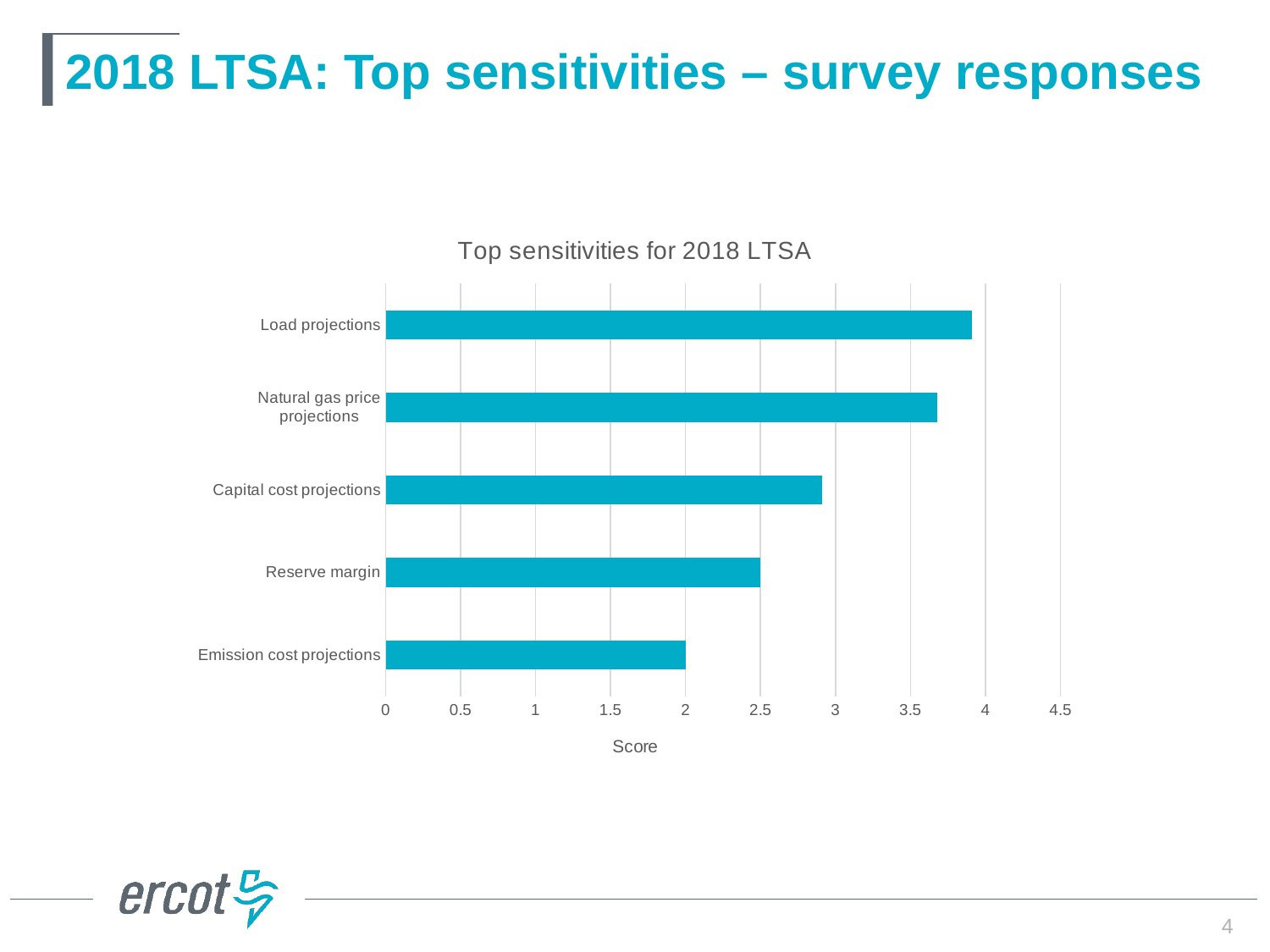
Is the score for Load projections greater or less than 3.5? greater What type of chart is shown on the slide? Bar chart What is the title of the chart? Top sensitivities for 2018 LTSA What is the score for Reserve margin? 2.5 Which category has the highest score? Load projections How many categories are plotted in the chart? 5 What is the score for Emission cost projections? 2 Which has a higher score, Capital cost projections or Reserve margin? Capital cost projections What is the label of the horizontal axis? Score Is the score for Capital cost projections greater or less than 3? less Which category has the lowest score? Emission cost projections Is the score for Natural gas price projections greater or less than 3.5? greater